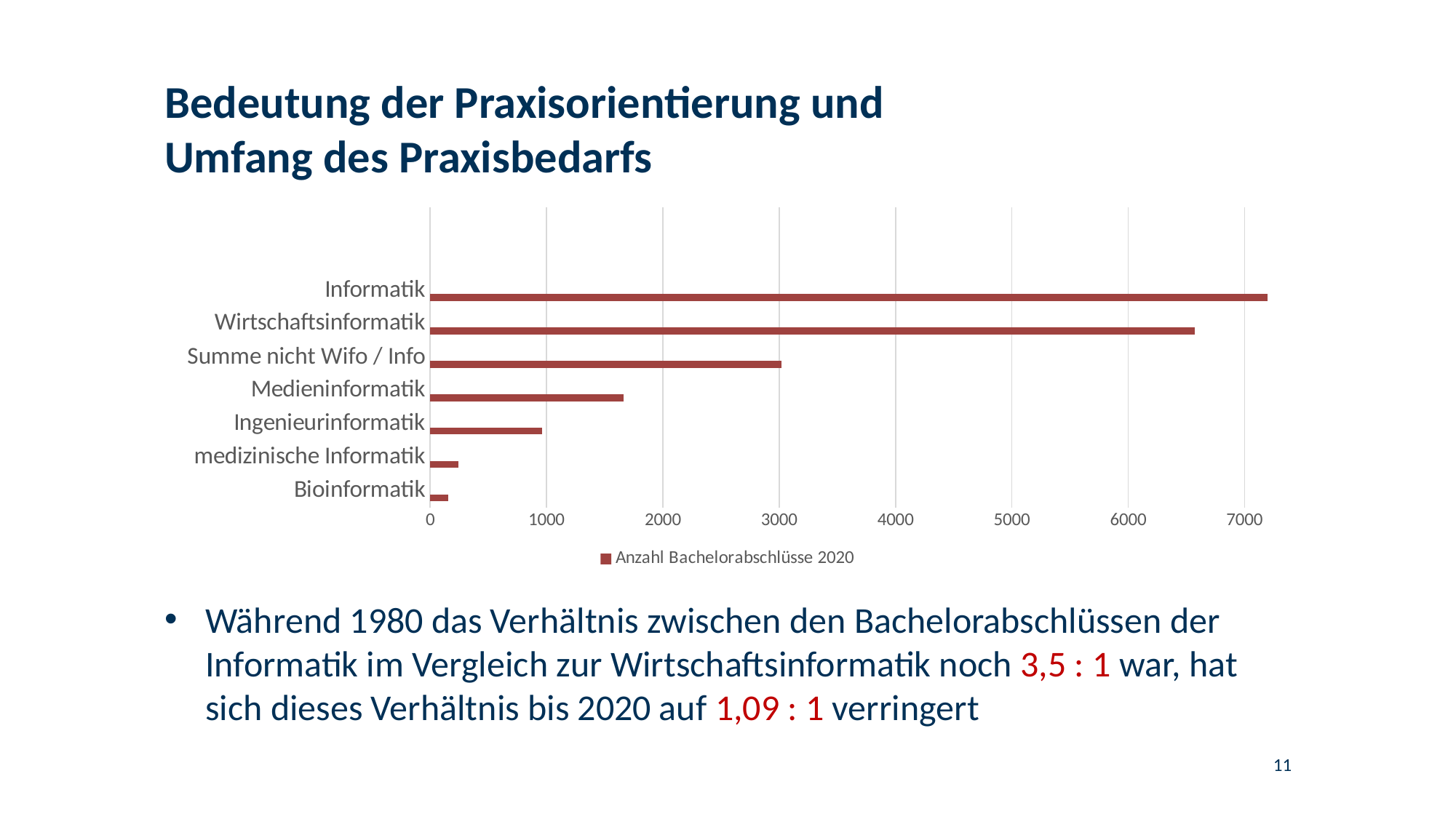
Which category has the lowest value? Bioinformatik How many series does the legend list? 1 What is the name of the series shown in the legend? Anzahl Bachelorabschlüsse 2020 What kind of chart is shown on the slide? bar chart Which is larger, the value for Medieninformatik or the value for Ingenieurinformatik? Medieninformatik Is the value for Informatik greater or less than 7000? greater Is the value for medizinische Informatik greater or less than 1000? less Which category has the highest value? Informatik Is the value for Wirtschaftsinformatik greater or less than 6000? greater Which is larger, the value for Wirtschaftsinformatik or the value for Summe nicht Wifo / Info? Wirtschaftsinformatik How many categories are shown on the chart? 7